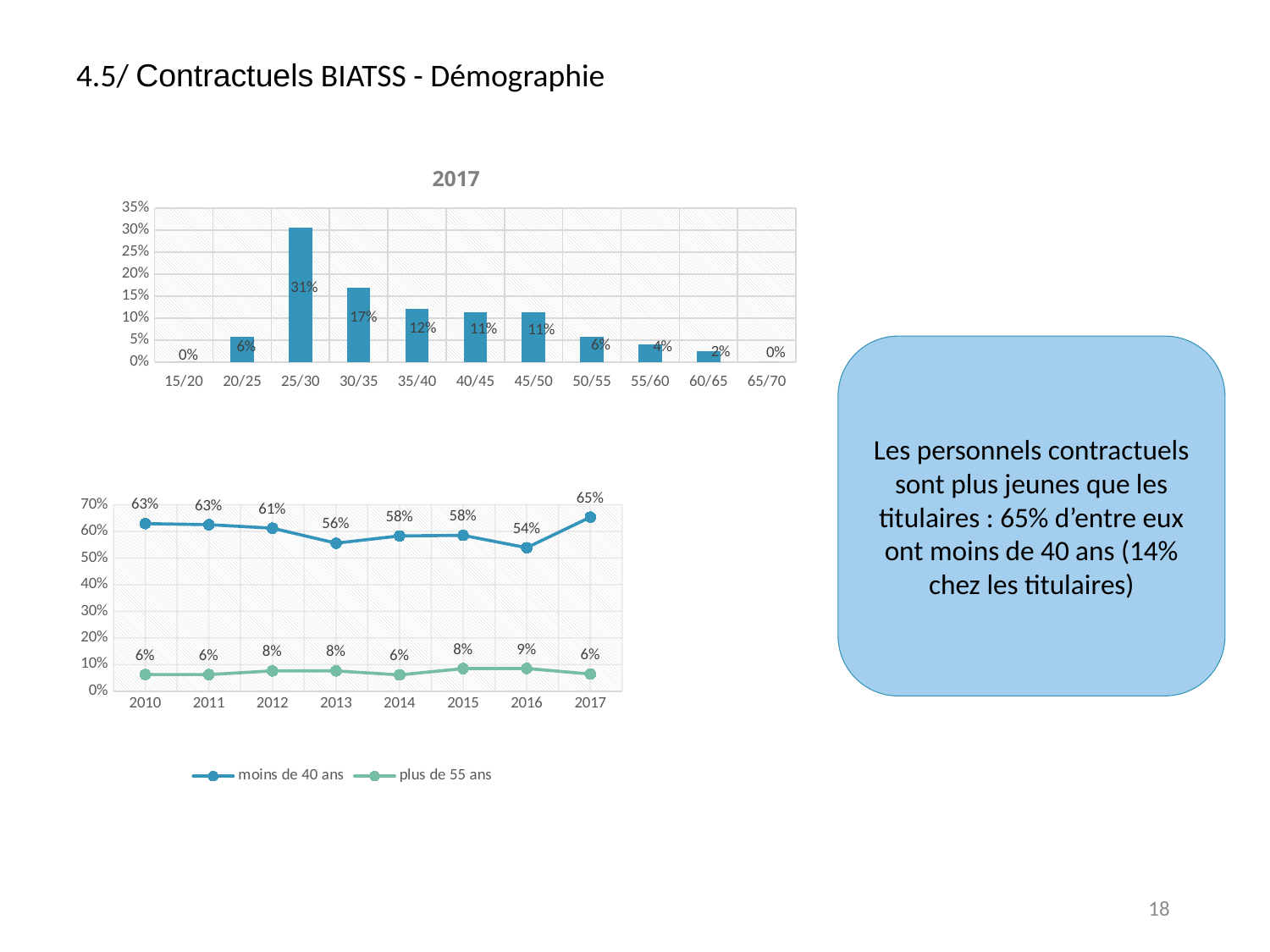
In the top chart titled "2017", how many age brackets are shown on the x axis? 11 In the top chart titled "2017", what is the value for the 30/35 age bracket? 17% In the top chart titled "2017", what is the difference between the values for 25/30 and 30/35? 14% In the top chart titled "2017", what is the value for the 25/30 age bracket? 31% What kind of chart is the top chart titled "2017"? Bar chart In the top chart titled "2017", which age bracket has the highest value? 25/30 In the bottom line chart, in which year is the value for "moins de 40 ans" lowest? 2016 In the top chart titled "2017", which is larger, the value for 35/40 or the value for 55/60? 35/40 In the bottom line chart, what is the value for "plus de 55 ans" in 2016? 9% In the bottom line chart, what is the difference between the "moins de 40 ans" and "plus de 55 ans" values in 2010? 57% In the bottom line chart, what is the value for "moins de 40 ans" in 2017? 65% How many series does the legend of the bottom line chart list? 2